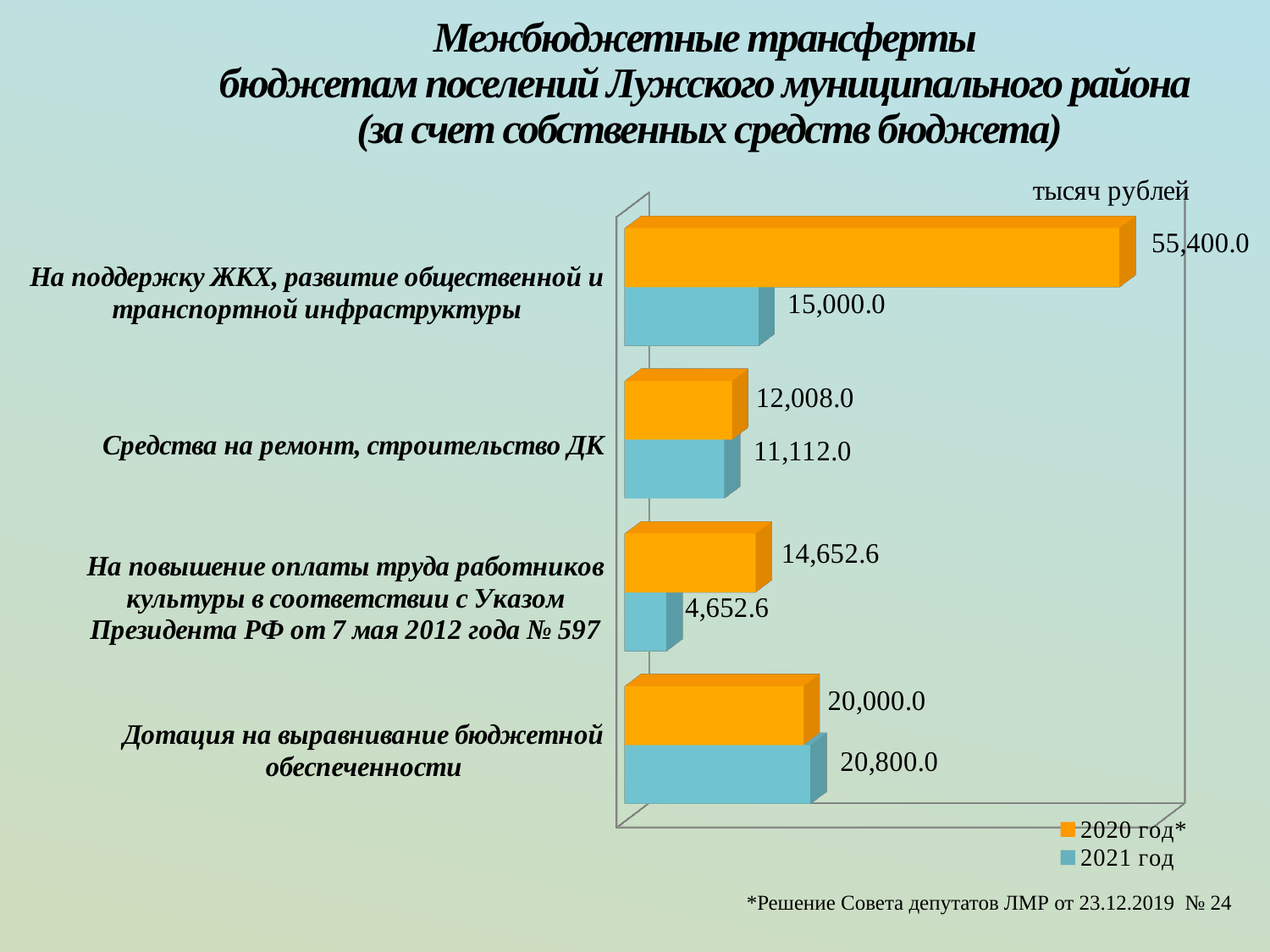
For «Дотация на выравнивание бюджетной обеспеченности», which year has the larger value, 2020 год* or 2021 год? 2021 год How many series does the legend list? 2 Which category has the lowest 2021 год value? На повышение оплаты труда работников культуры в соответствии с Указом Президента РФ от 7 мая 2012 года № 597 What is the difference between the 2020 год* and 2021 год values for «На поддержку ЖКХ, развитие общественной и транспортной инфраструктуры»? 40,400.0 What is the 2020 год* value for «На поддержку ЖКХ, развитие общественной и транспортной инфраструктуры»? 55,400.0 What kind of chart is shown on the slide? Bar chart What is the difference between the 2020 год* and 2021 год values for «На повышение оплаты труда работников культуры в соответствии с Указом Президента РФ от 7 мая 2012 года № 597»? 10,000.0 What is the 2021 год value for «Средства на ремонт, строительство ДК»? 11,112.0 Which category has the highest 2020 год* value? На поддержку ЖКХ, развитие общественной и транспортной инфраструктуры What is the 2020 год* value for «Дотация на выравнивание бюджетной обеспеченности»? 20,000.0 What is the 2021 год value for «На повышение оплаты труда работников культуры в соответствии с Указом Президента РФ от 7 мая 2012 года № 597»? 4,652.6 How many categories are shown in the chart? 4